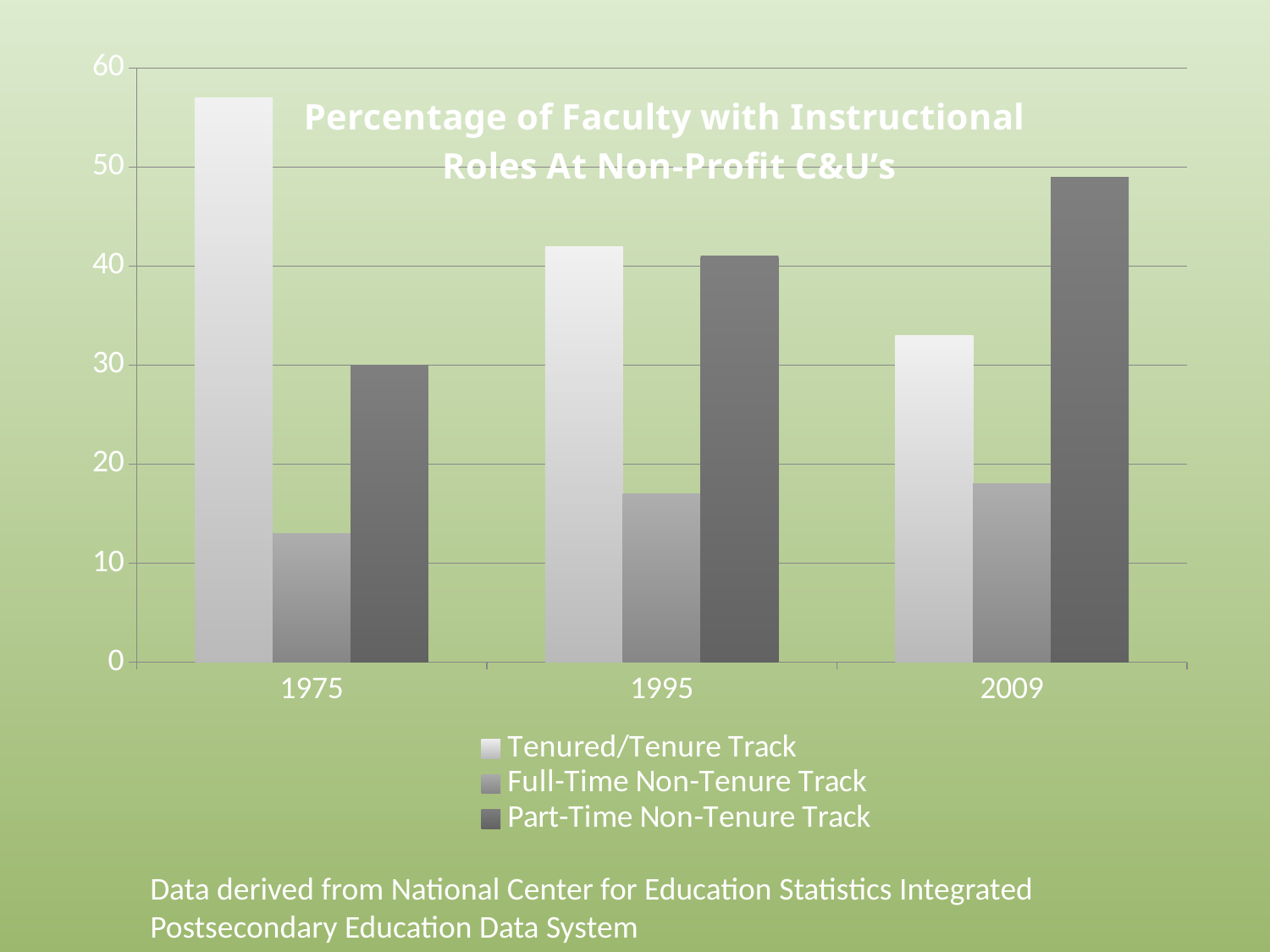
In which year is the Part-Time Non-Tenure Track value highest? 2009 Does the Part-Time Non-Tenure Track value rise or fall from 1975 to 2009? rise How many years are shown on the x axis of the chart? 3 What kind of chart is shown on the slide? bar chart In 2009, which is larger: Tenured/Tenure Track or Part-Time Non-Tenure Track? Part-Time Non-Tenure Track Does the Tenured/Tenure Track value rise or fall from 1975 to 2009? fall Is the Tenured/Tenure Track value for 1975 greater or less than 50? greater Is the Full-Time Non-Tenure Track value for 2009 greater or less than 20? less What is the title of the chart? Percentage of Faculty with Instructional Roles At Non-Profit C&U's In which year is the Tenured/Tenure Track value highest? 1975 How many series does the chart's legend list? 3 In which year is the Tenured/Tenure Track value lowest? 2009